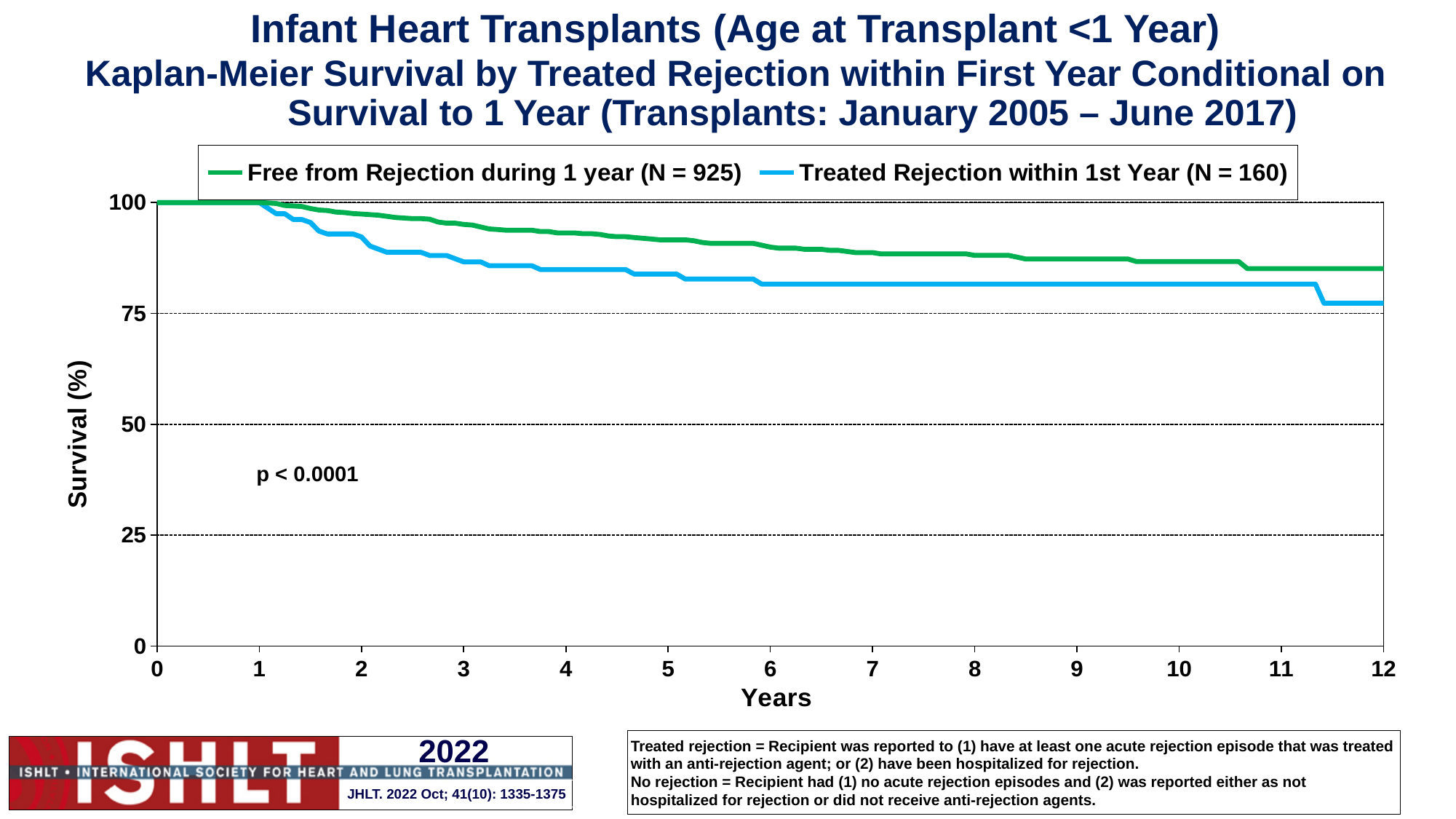
Do the survival values rise or fall as years increase? Fall What p-value is printed on the chart? p < 0.0001 What is the N for the Free from Rejection during 1 year series shown in the legend? 925 Is the survival value for Treated Rejection within 1st Year at 6 years greater or less than 75? greater Is the survival value for Free from Rejection during 1 year at 12 years greater or less than 75? greater Is the survival value for Treated Rejection within 1st Year at 2 years greater or less than 100? less What kind of chart is shown on the slide? Line chart What is the survival value for both series at 0 years? 100 Which series has the lower survival at 8 years? Treated Rejection within 1st Year How many series does the legend list? 2 Which series has the higher survival at 12 years, Free from Rejection during 1 year or Treated Rejection within 1st Year? Free from Rejection during 1 year